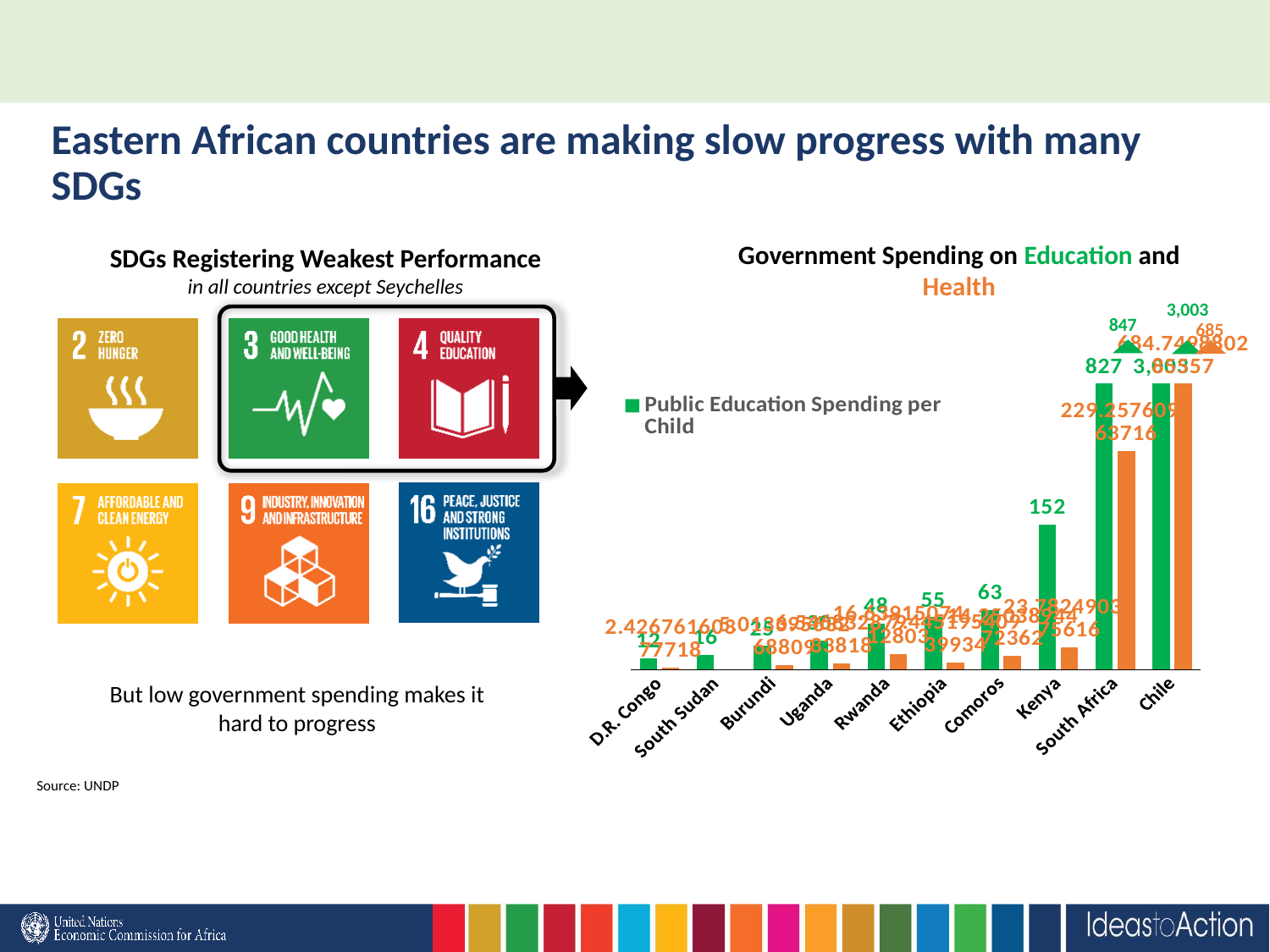
Which country has the lowest Public Education Spending per Child? D.R. Congo How many countries are shown on the x axis of the Government Spending chart? 10 Which country has the highest Public Education Spending per Child? Chile What is the Public Education Spending per Child value for South Africa? 827 What is the difference in Public Education Spending per Child between Kenya and Comoros? 89 What is the Public Education Spending per Child value for Chile? 3,003 What is the Public Education Spending per Child value for Comoros? 63 What is the Public Education Spending per Child value for Kenya? 152 Do the Public Education Spending per Child values generally rise or fall from D.R. Congo to Chile along the x axis? rise How many series does the legend of the Government Spending chart list? 1 Which has the larger Public Education Spending per Child, Ethiopia or Rwanda? Ethiopia What kind of chart is shown under the title 'Government Spending on Education and Health'? bar chart